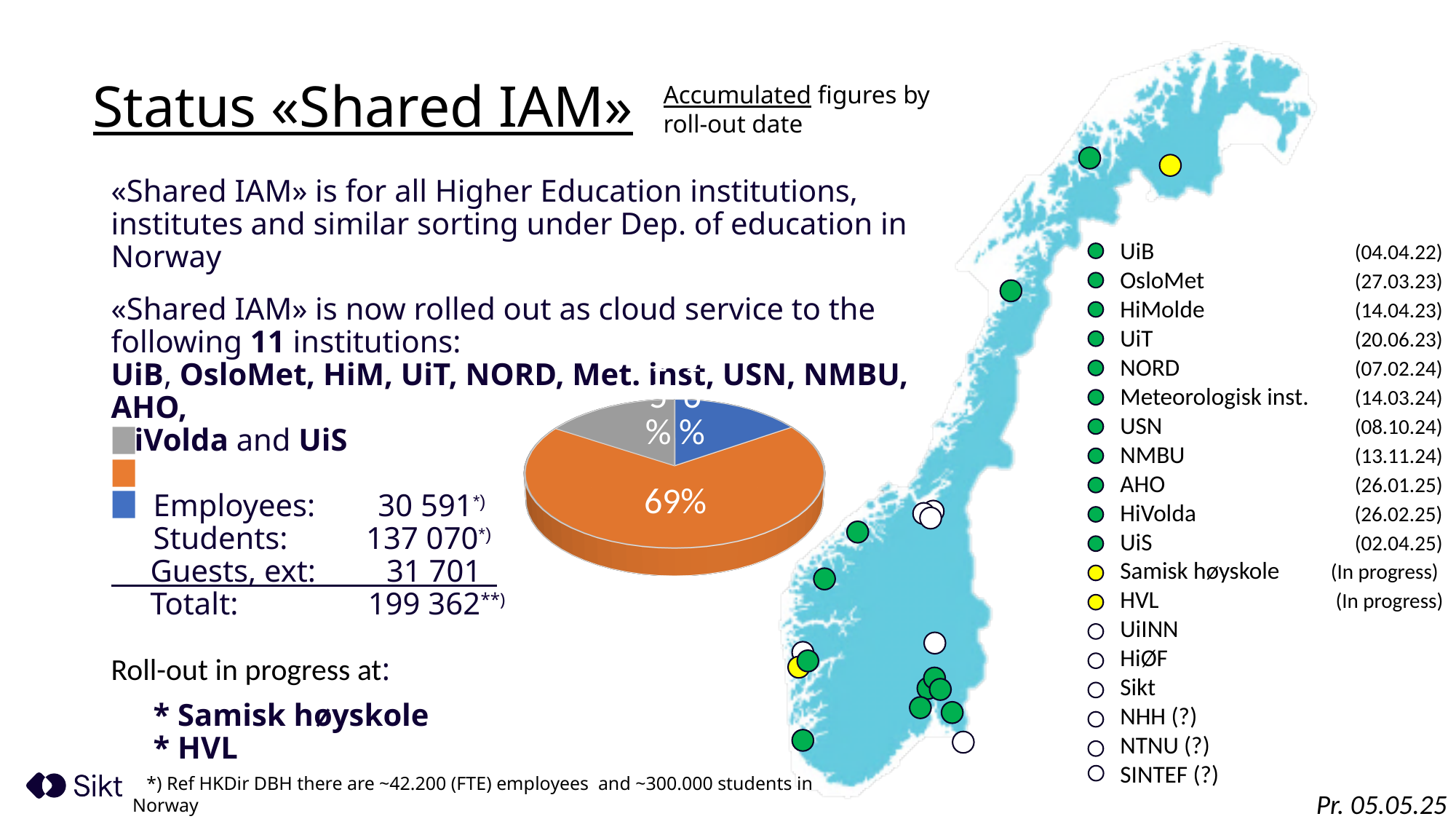
Which group from the figures on the slide does the 69% slice of the pie chart represent? Students What kind of chart is shown on the slide? pie chart Which slice of the pie chart is larger, the orange slice or the grey slice? the orange slice What percentage is shown on the largest slice of the pie chart? 69% Does the largest slice of the pie chart account for more than half of the total? yes Which slice of the pie chart is larger, the orange slice or the blue slice? the orange slice Is the orange slice of the pie chart greater or less than 50%? greater What colour is the largest slice of the pie chart? orange Is the pie chart drawn in 3D? yes How many slices does the pie chart have? 3